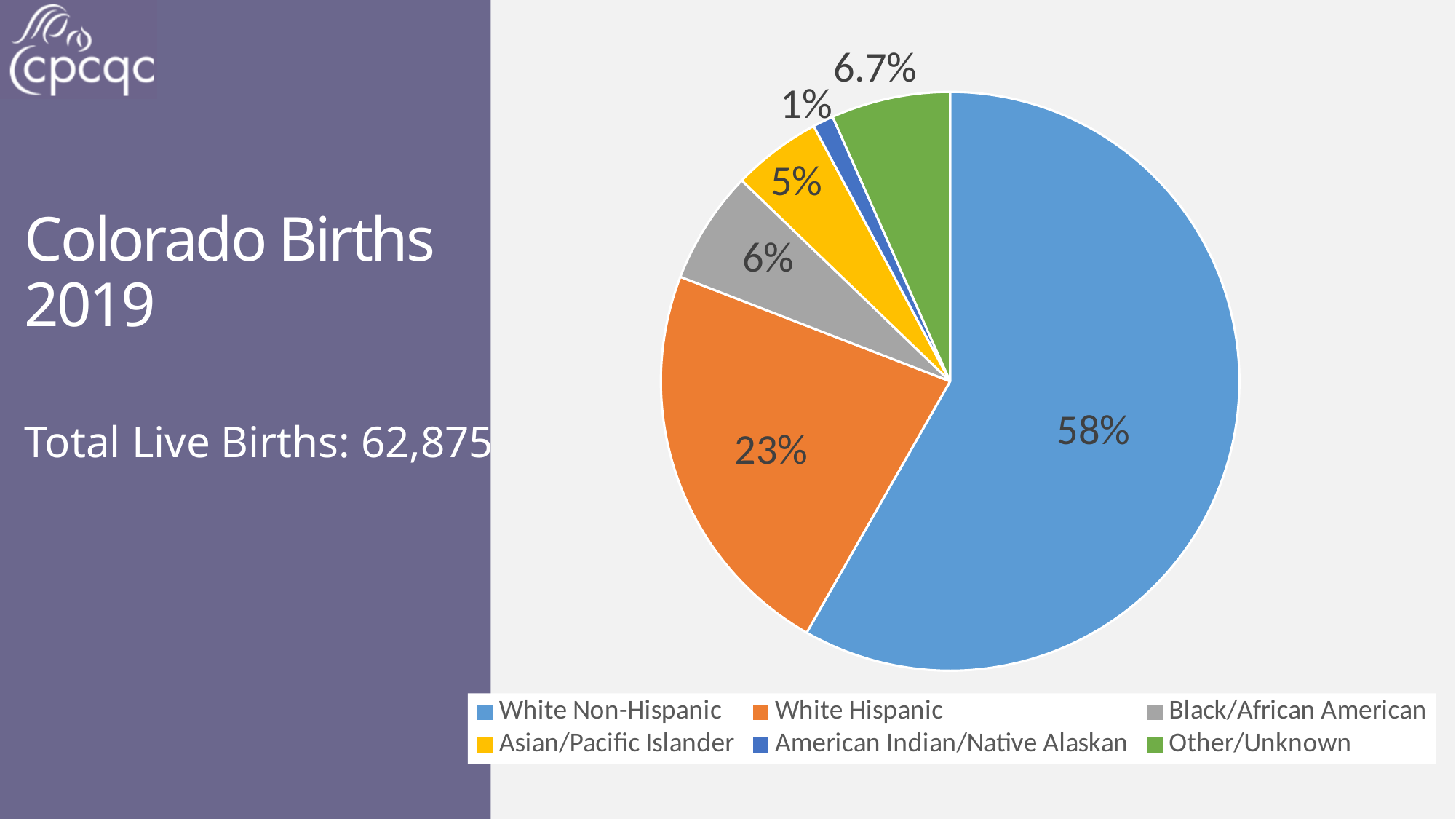
What share of Colorado births in 2019 were White Hispanic? 23% What share of Colorado births in 2019 were American Indian/Native Alaskan? 1% What kind of chart is shown on the slide? pie chart Which category has the smallest slice of the pie? American Indian/Native Alaskan What share of Colorado births in 2019 were White Non-Hispanic? 58% What share of Colorado births in 2019 were Black/African American? 6% What colour is the White Hispanic slice? orange What share of Colorado births in 2019 were Asian/Pacific Islander? 5% How many categories does the pie chart show? 6 Which category has the largest slice of the pie? White Non-Hispanic What share of Colorado births in 2019 were Other/Unknown? 6.7% What is the difference in percentage points between the White Non-Hispanic and White Hispanic slices? 35 percentage points